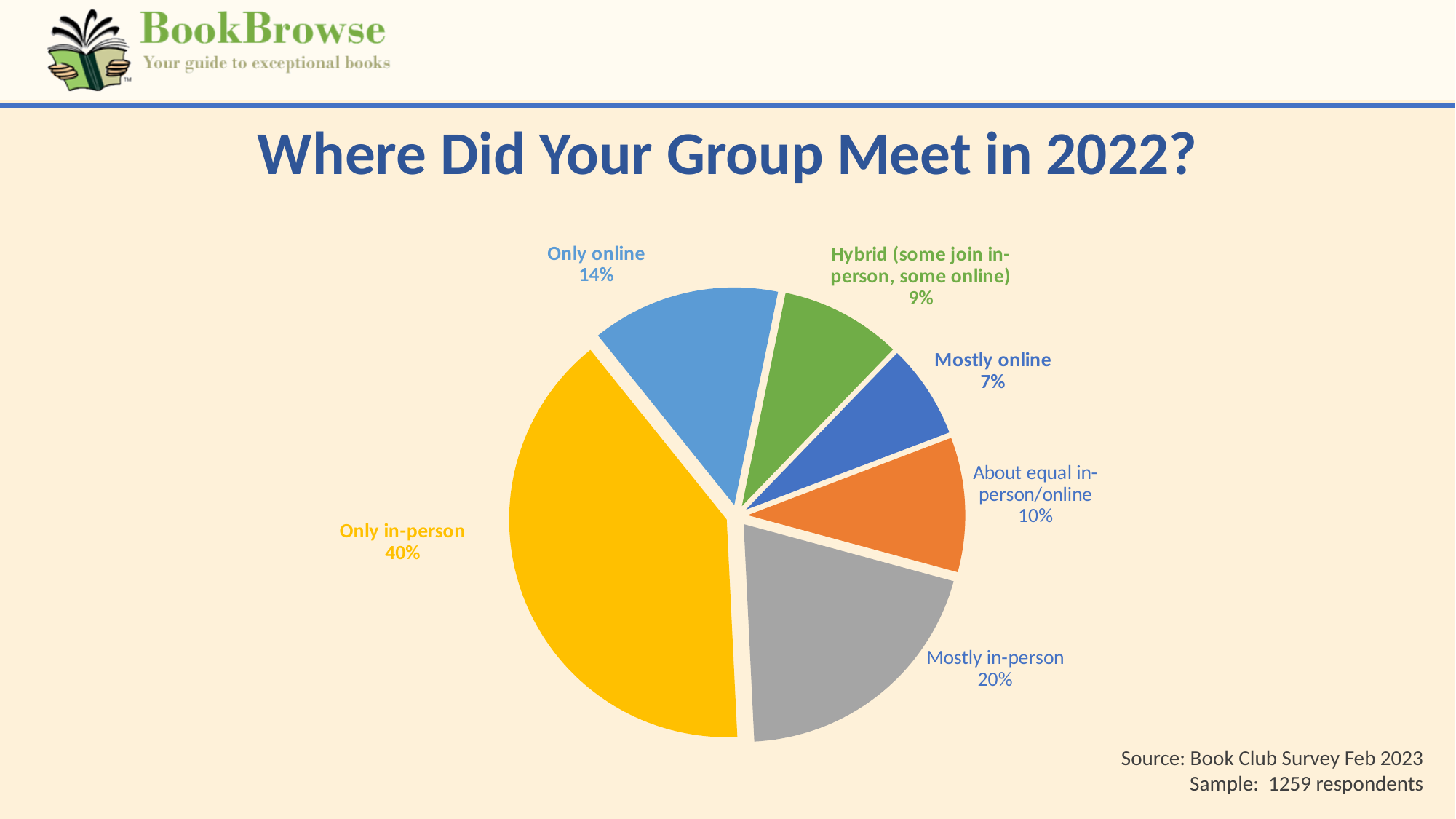
What type of chart is shown on the slide? Pie chart What percentage of groups met only online? 14% What percentage is shown for 'Hybrid (some join in-person, some online)'? 9% What is the title of the chart? Where Did Your Group Meet in 2022? Which is larger: 'About equal in-person/online' or 'Hybrid (some join in-person, some online)'? About equal in-person/online Which category has the largest slice of the pie? Only in-person What colour is the 'Only in-person' slice? Yellow What share is shown for 'Mostly in-person'? 20% What percentage of groups met only in-person? 40% Which category has the smallest slice of the pie? Mostly online How many categories are shown in the pie chart? 6 What is the difference in percentage points between 'Only in-person' and 'Mostly in-person'? 20